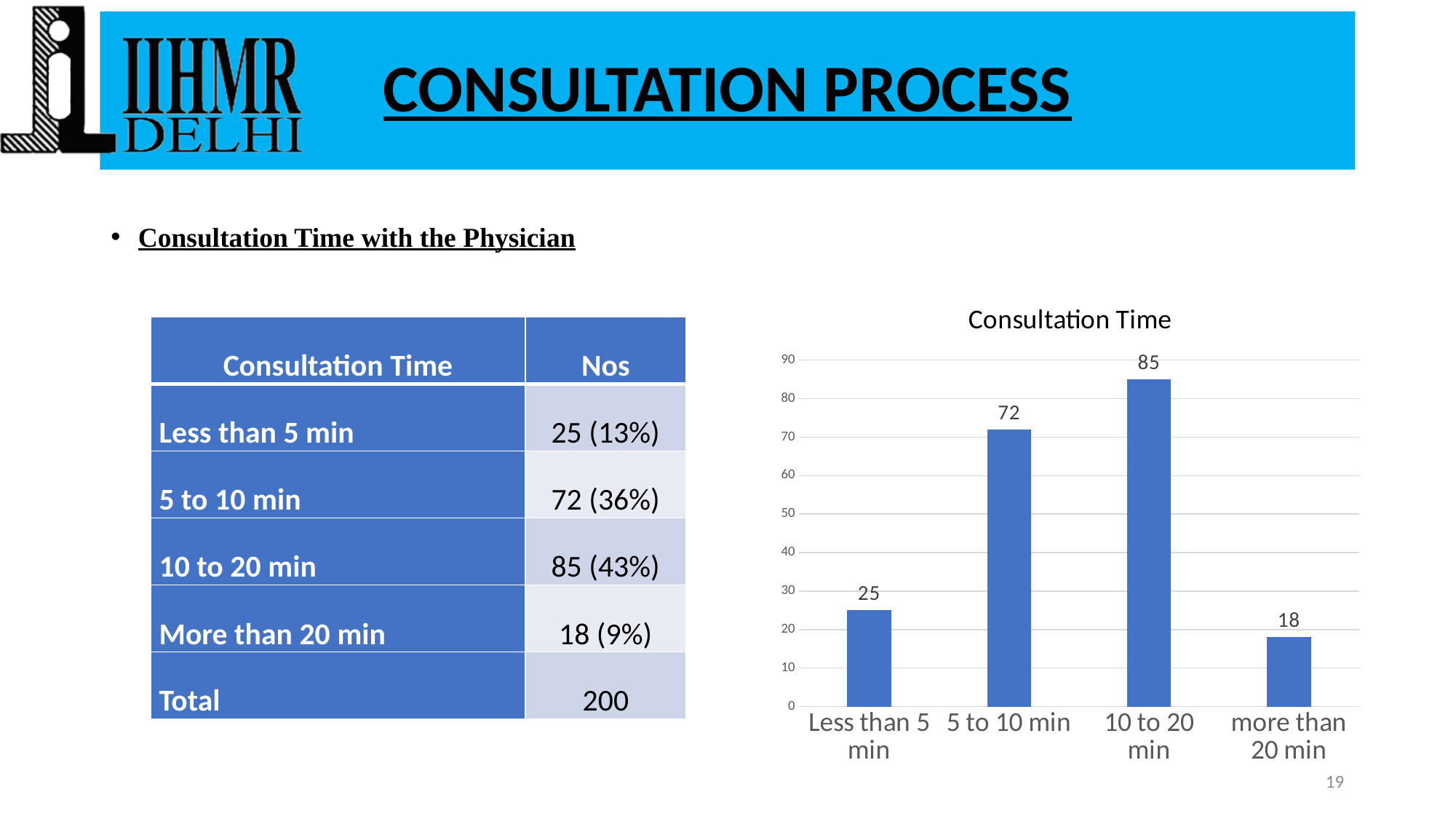
What is the value for '10 to 20 min' in the Consultation Time chart? 85 What is the value for 'Less than 5 min' in the Consultation Time chart? 25 What is the title of the chart on the slide? Consultation Time In the Consultation Time chart, which is larger: the value for '5 to 10 min' or the value for 'Less than 5 min'? 5 to 10 min What is the difference between the values for '10 to 20 min' and '5 to 10 min' in the Consultation Time chart? 13 Which category has the lowest value in the Consultation Time chart? more than 20 min What is the value for 'more than 20 min' in the Consultation Time chart? 18 What is the difference between the values for 'Less than 5 min' and 'more than 20 min' in the Consultation Time chart? 7 What is the value for '5 to 10 min' in the Consultation Time chart? 72 How many categories are shown in the Consultation Time chart? 4 Which category has the highest value in the Consultation Time chart? 10 to 20 min What kind of chart is the Consultation Time chart? Bar chart